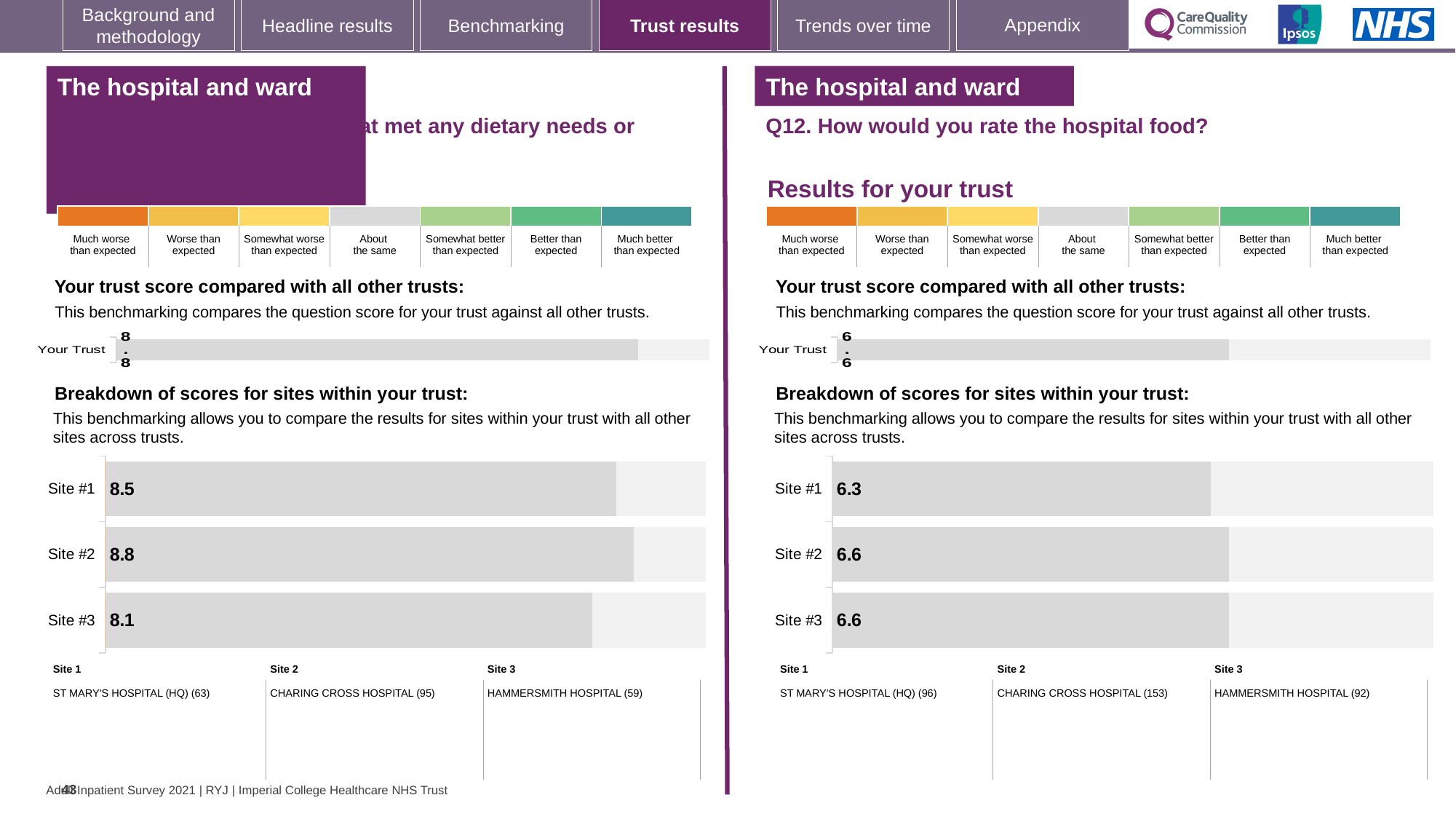
On the Q12 hospital food chart (breakdown of scores for sites), what is the difference between the scores for Site #2 and Site #1? 0.3 On the left-hand chart (breakdown of scores for sites), which site has the lowest score? Site #3 On the left-hand chart (breakdown of scores for sites), what is the score for Site #3? 8.1 On the Q12 hospital food chart (breakdown of scores for sites), what is the score for Site #1? 6.3 On the Q12 hospital food chart (breakdown of scores for sites), which site has the lowest score? Site #1 On the left-hand chart (breakdown of scores for sites), what is the difference between the scores for Site #2 and Site #3? 0.7 On the left-hand chart (breakdown of scores for sites), what is the score for Site #1? 8.5 On the Q12 hospital food chart (breakdown of scores for sites), what is the score for Site #2? 6.6 On the left-hand chart (breakdown of scores for sites), which site has the highest score? Site #2 On the Q12 hospital food 'Your trust score compared with all other trusts' chart, what is the score for Your Trust? 6.6 On the left-hand 'Your trust score compared with all other trusts' chart, what is the score for Your Trust? 8.8 How many sites are shown in the Q12 hospital food breakdown of scores chart? 3